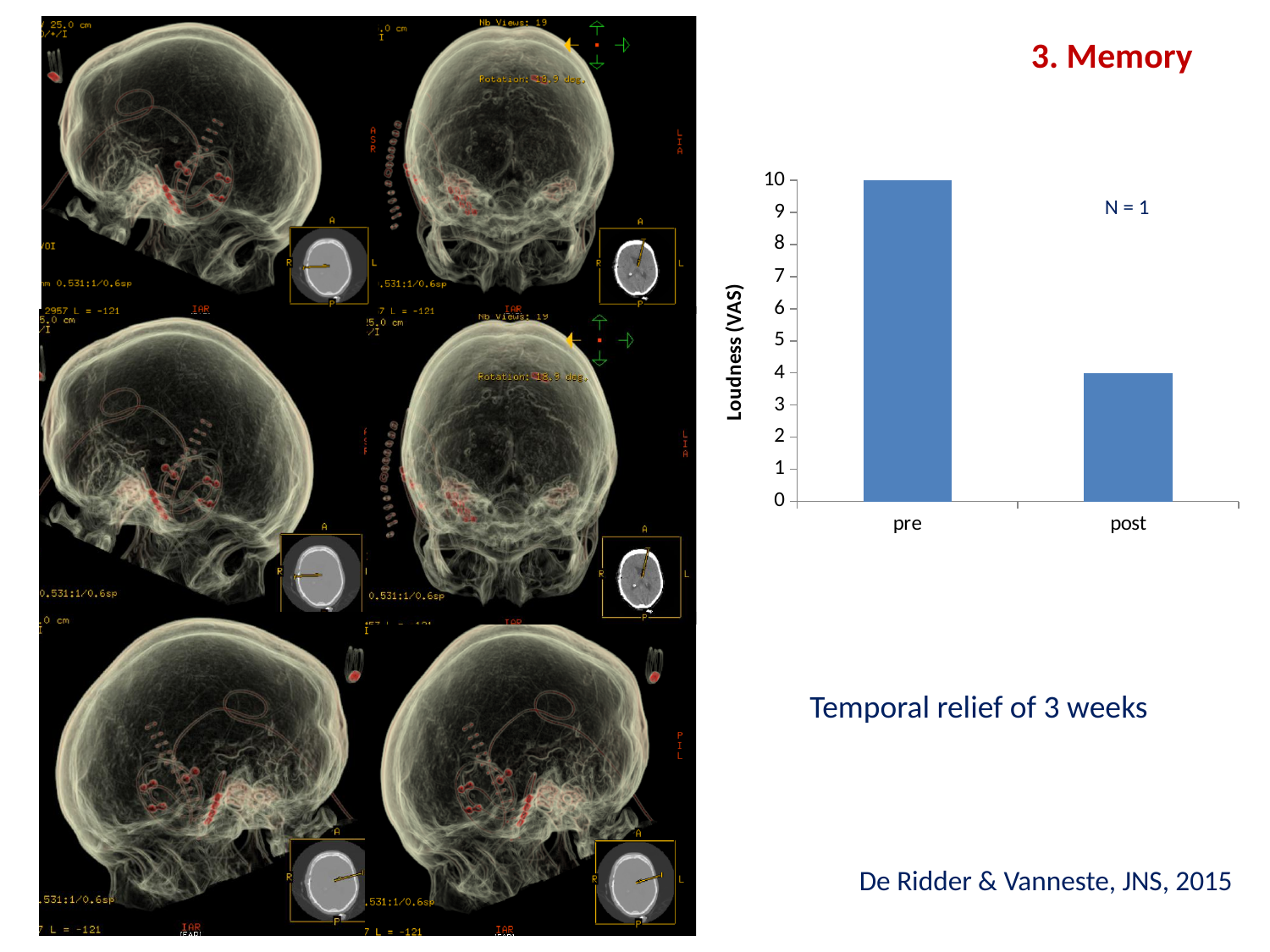
Do the values rise or fall from pre to post? fall How many categories are shown on the x axis of the chart? 2 What is the Loudness (VAS) value for post? 4 What is the label of the y axis of the chart? Loudness (VAS) Is the Loudness (VAS) value for pre larger or smaller than the value for post? larger Is the value for post greater or less than 5? less What is the Loudness (VAS) value for pre? 10 What is the difference in Loudness (VAS) between pre and post? 6 Which category has the higher Loudness (VAS) value? pre Which category has the lower Loudness (VAS) value? post What sample size (N) is noted on the chart? N = 1 What kind of chart is shown on the slide? bar chart